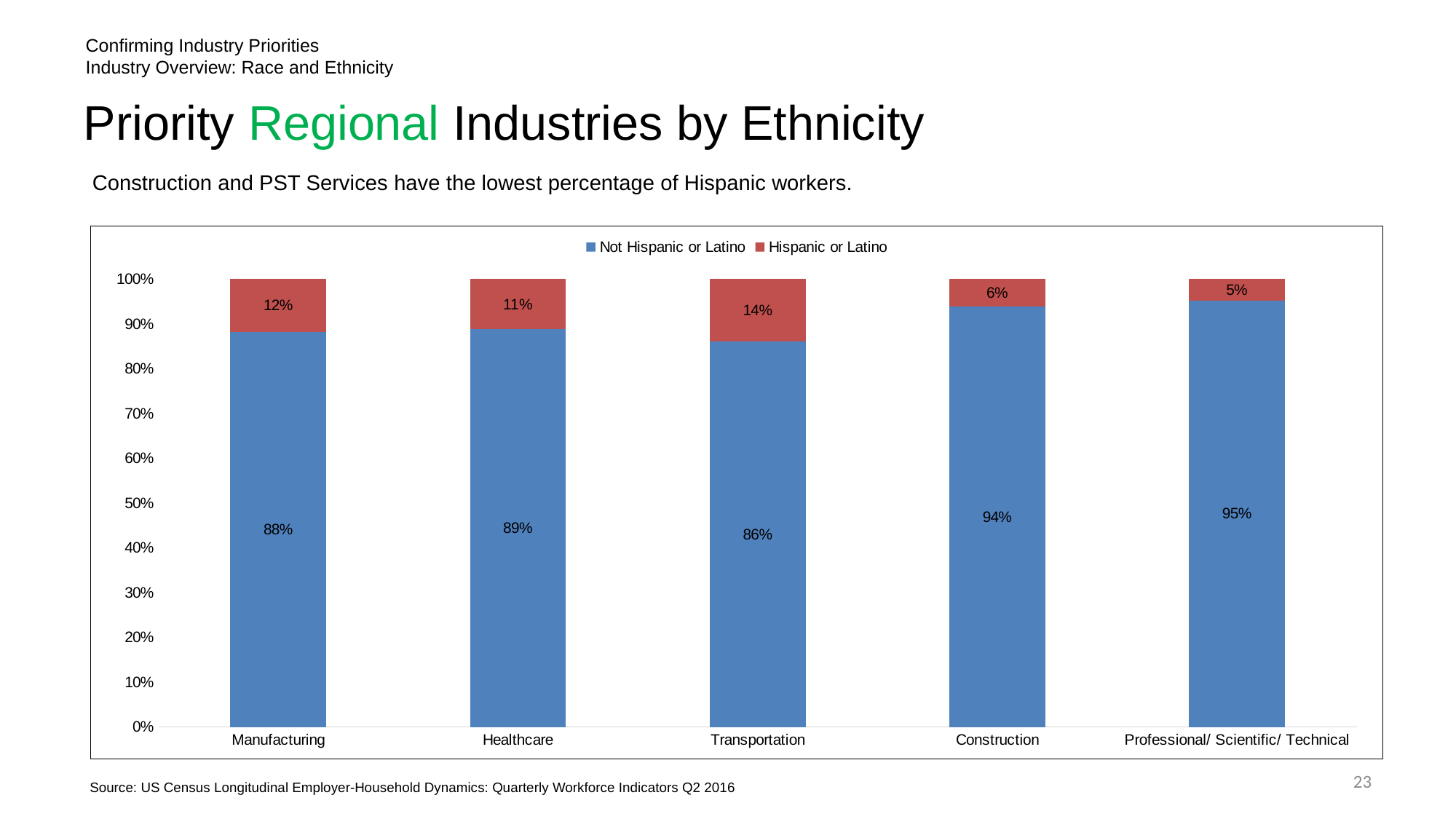
Which industry has the highest Hispanic or Latino percentage? Transportation How many series does the legend list? 2 How many industries are shown on the x axis? 5 What is the total of the stacked bar for Healthcare? 100% Which colour represents the Hispanic or Latino series? Red What is the Not Hispanic or Latino percentage for Construction? 94% Which industry has the lowest Not Hispanic or Latino percentage? Transportation What is the Hispanic or Latino percentage for Transportation? 14% What is the difference between the Hispanic or Latino percentages for Manufacturing and Construction? 6% What kind of chart is shown on the slide? Stacked bar chart Which is larger, the Hispanic or Latino percentage for Healthcare or for Construction? Healthcare What is the Hispanic or Latino percentage for Professional/ Scientific/ Technical? 5%